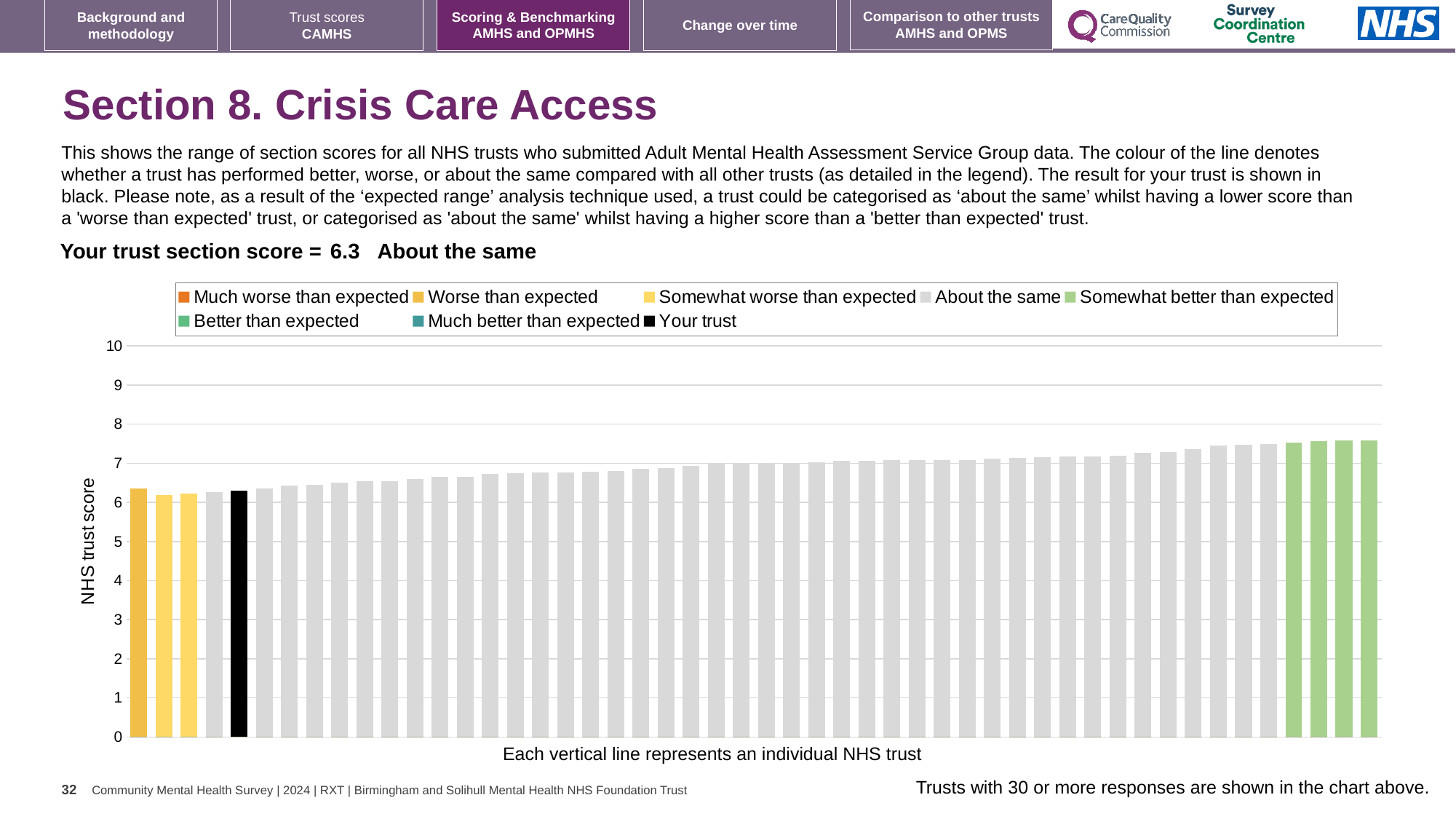
Is the value for your trust (the black bar) greater or less than 5? greater What is the label on the vertical axis of the chart? NHS trust score Do the bar values rise or fall moving from left to right along the x axis? Rise Is the value of the tallest bar in the chart greater or less than 8? less What is the highest value shown on the vertical axis scale? 10 What colour does the legend use for 'Your trust'? Black Which is larger: the value for your trust (black bar) or the value of the rightmost bar? The rightmost bar What is the section score for your trust shown on the slide? 6.3 How many bars in the chart are shaded green (somewhat better than expected)? 4 Which category is your trust placed in according to the text above the chart? About the same What kind of chart is shown on the slide? Bar chart How many entries does the chart legend list? 8